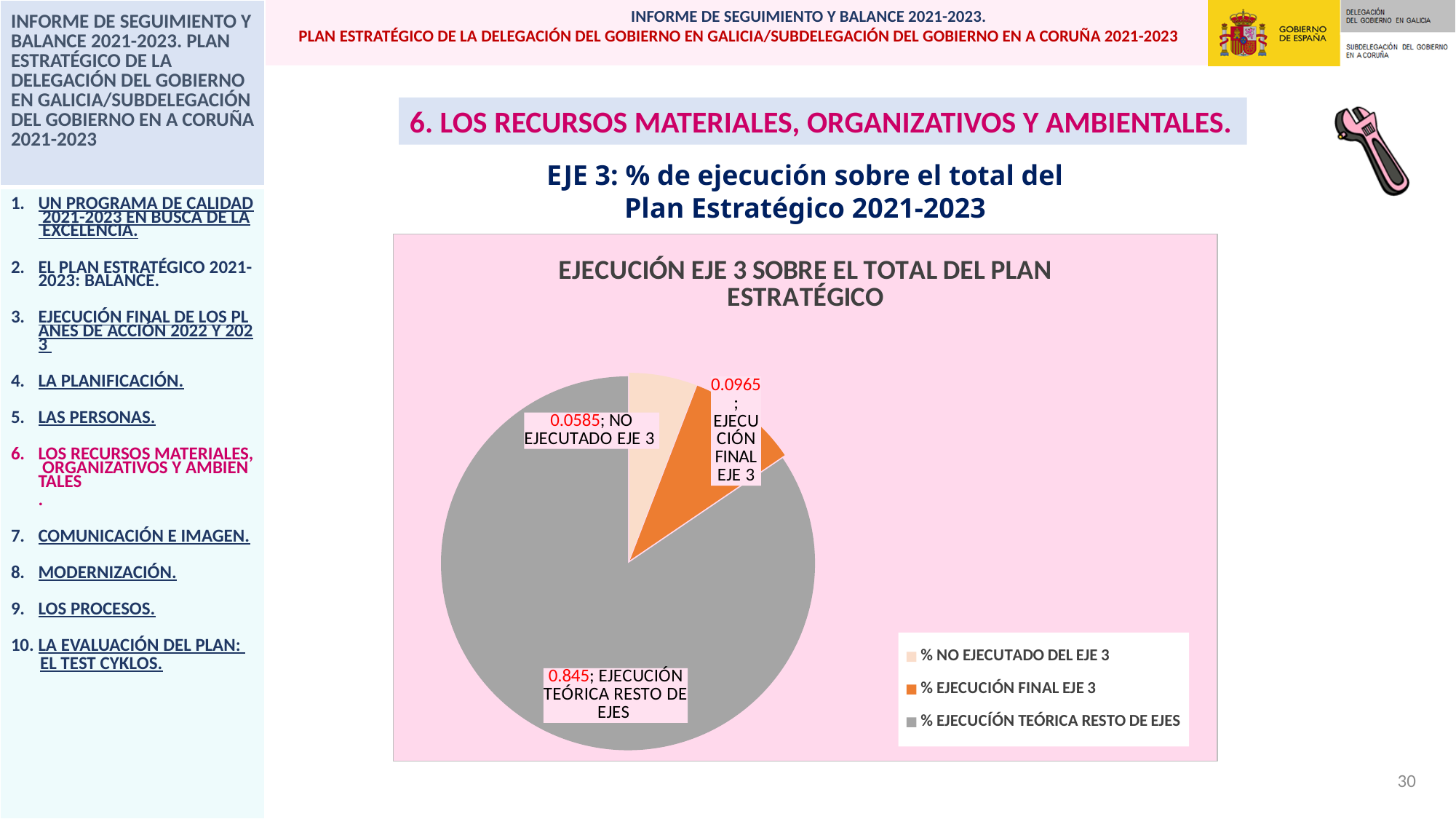
What is the title of the chart? EJECUCIÓN EJE 3 SOBRE EL TOTAL DEL PLAN ESTRATÉGICO What is the difference between the values for EJECUCIÓN FINAL EJE 3 and NO EJECUTADO EJE 3? 0.038 What colour is the slice for % EJECUCIÓN TEÓRICA RESTO DE EJES? Grey What kind of chart is shown on the slide? Pie chart Which slice of the pie chart is the smallest? NO EJECUTADO EJE 3 How many entries does the chart legend list? 3 What is the value shown for EJECUCIÓN TEÓRICA RESTO DE EJES? 0.845 What is the value shown for EJECUCIÓN FINAL EJE 3? 0.0965 Which is larger, EJECUCIÓN FINAL EJE 3 or NO EJECUTADO EJE 3? EJECUCIÓN FINAL EJE 3 How many slices does the pie chart have? 3 What is the value shown for NO EJECUTADO EJE 3? 0.0585 Which slice of the pie chart is the largest? EJECUCIÓN TEÓRICA RESTO DE EJES